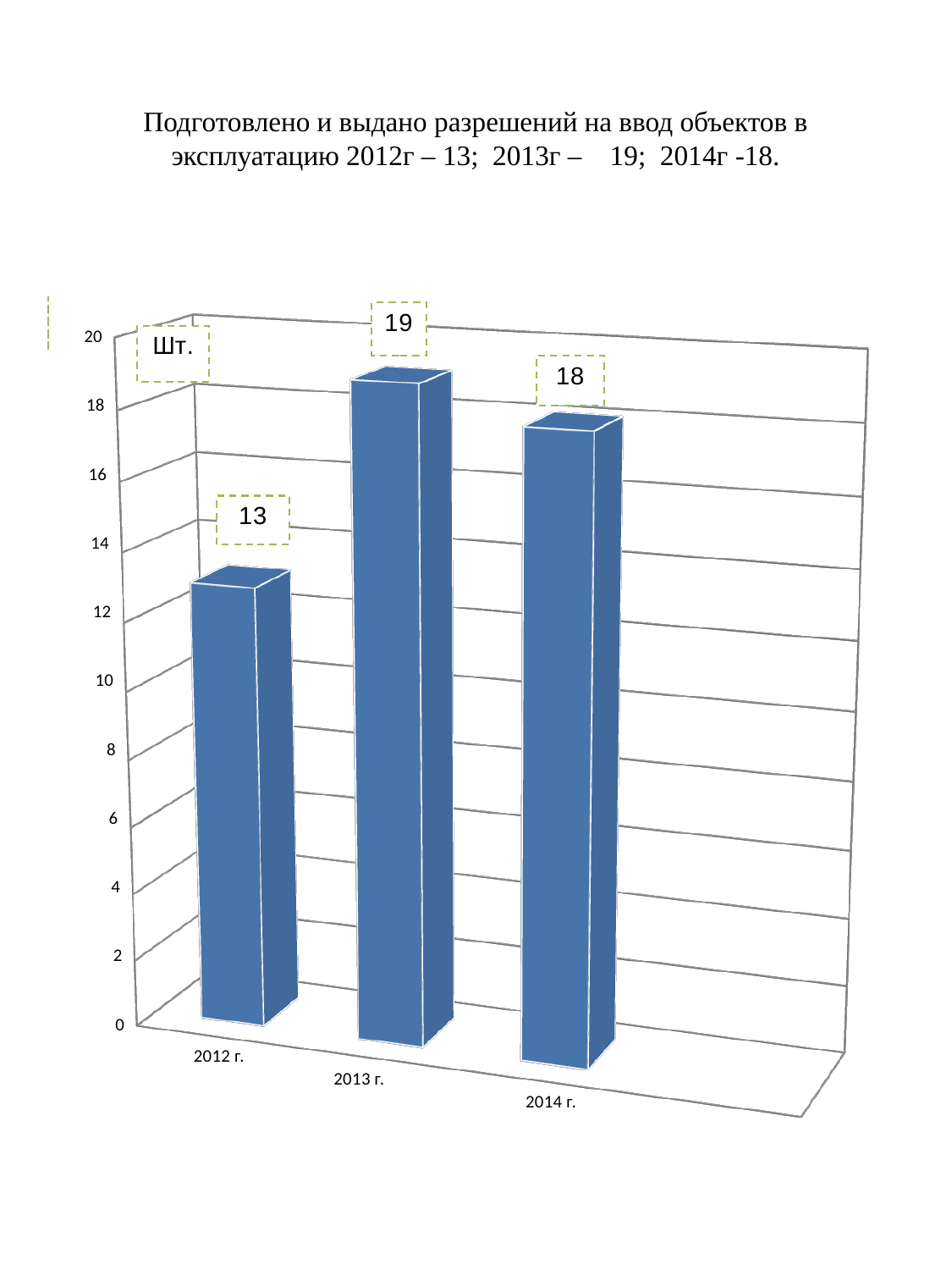
Is the value for 2012 г. greater or less than 14? less How many years are shown on the chart? 3 What kind of chart is shown on the slide? bar chart Which is larger, the value for 2014 г. or the value for 2012 г.? 2014 г. What is the difference between the values for 2013 г. and 2014 г.? 1 What is the value for 2013 г.? 19 What is the value for 2012 г.? 13 Which year has the lowest value? 2012 г. What is the difference between the values for 2013 г. and 2012 г.? 6 What unit label is shown in the box near the top of the vertical axis? Шт. What is the value for 2014 г.? 18 Which year has the highest value? 2013 г.